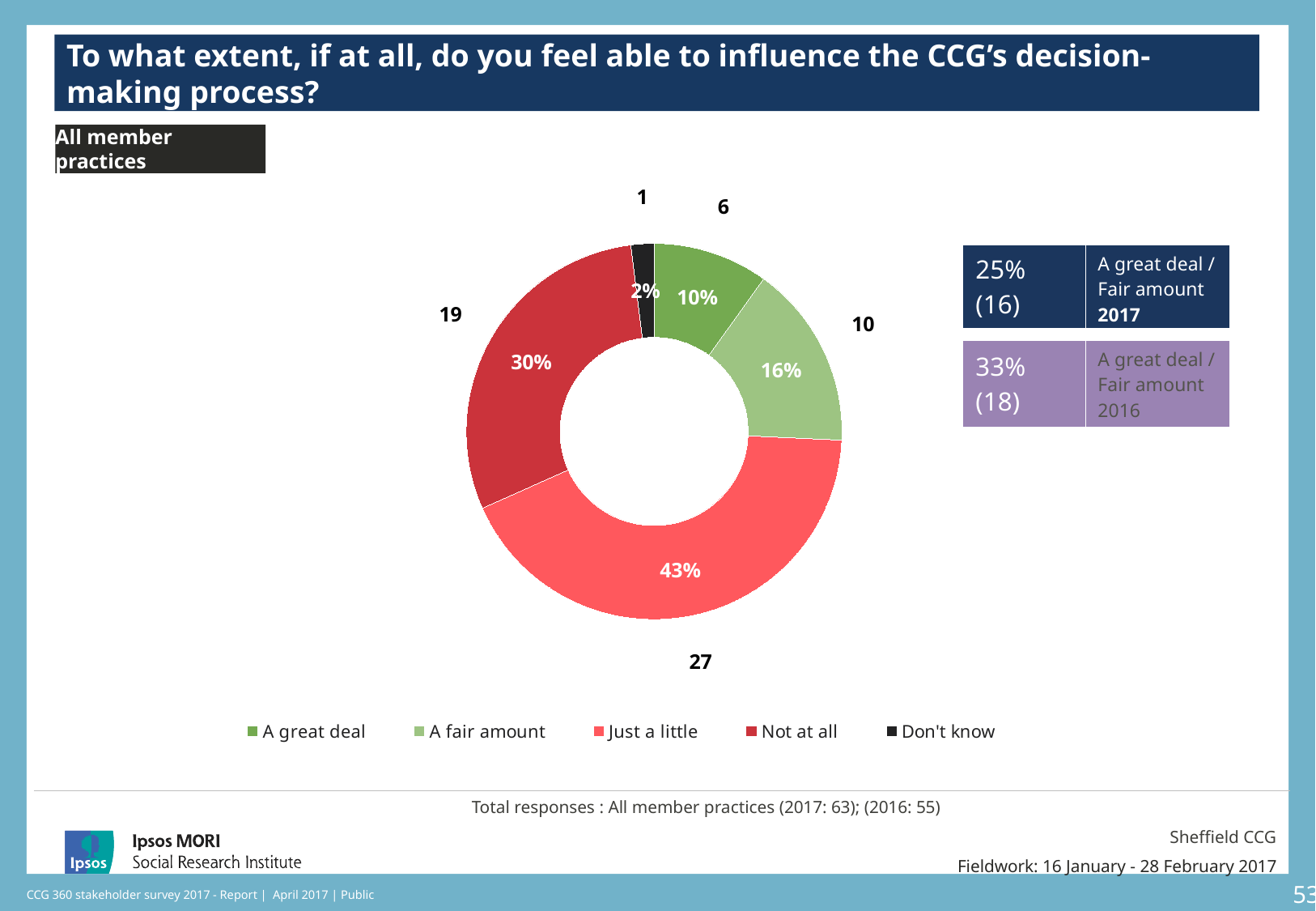
What percentage of respondents said 'Not at all'? 30% What type of chart is shown on the slide? Donut (pie) chart Which is larger, the share for 'A fair amount' or the share for 'A great deal'? A fair amount What percentage of respondents said 'Just a little'? 43% How many response categories does the legend list? 5 What colour is used for the 'Not at all' segment? Dark red What percentage of respondents said 'A great deal'? 10% Which response category has the largest share of the chart? Just a little Which response category has the smallest share of the chart? Don't know What is the difference in percentage points between 'Just a little' and 'Not at all'? 13 How many respondents answered 'Don't know', according to the count label outside the ring? 1 How many respondents answered 'A fair amount', according to the count label outside the ring? 10